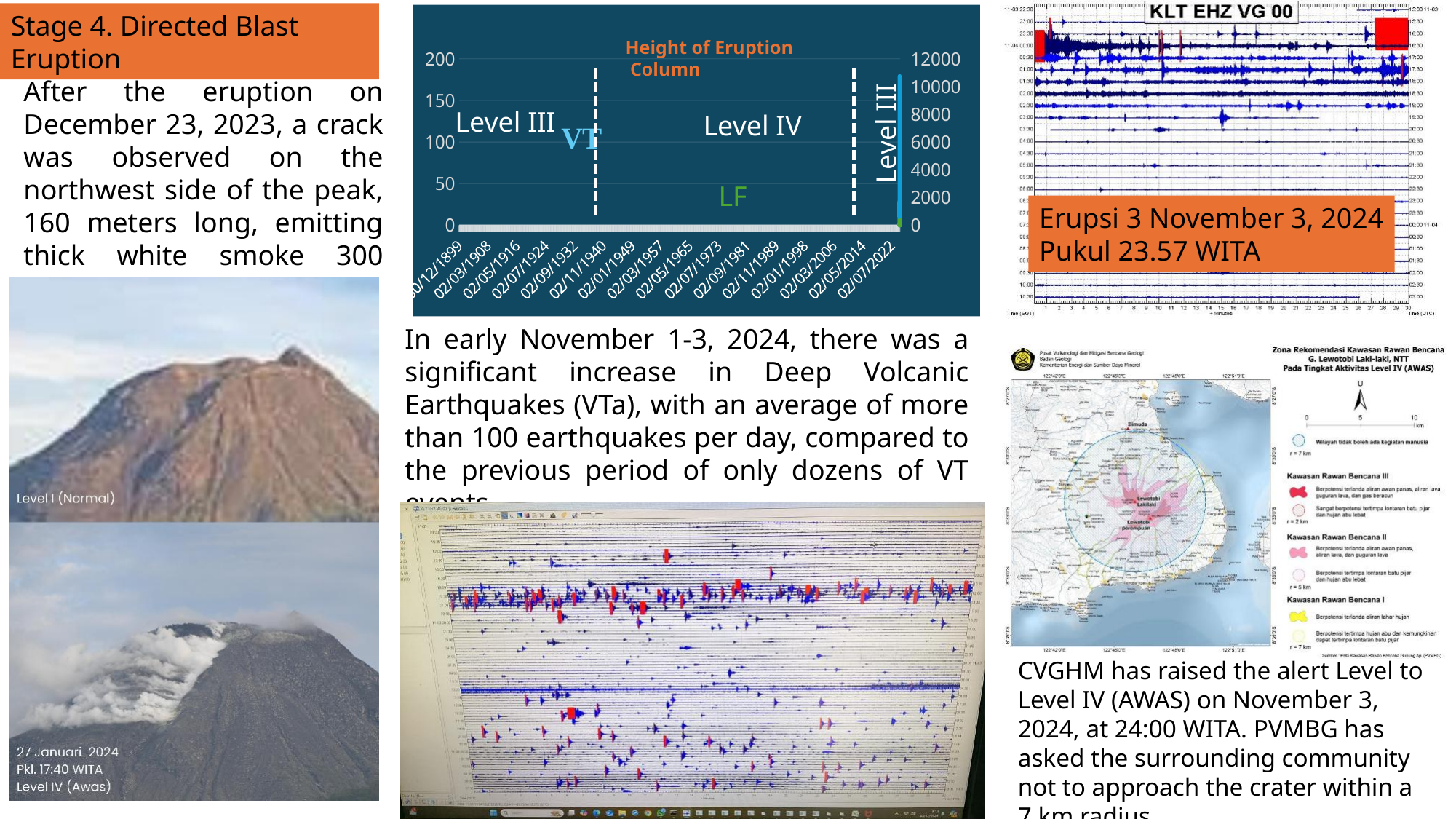
Do the values on the top-centre chart stay flat or rise sharply at the right end of the x axis? rise sharply at the right end What is the first date label on the x axis of the top-centre chart? 30/12/1899 On the top-centre chart, is the blue spike at 02/07/2022, read against the right-hand axis, greater or less than 6000? greater On the top-centre chart, is the value at 02/05/2014 greater or less than 2000 on the right-hand axis? less What is the last date label on the x axis of the top-centre chart? 02/07/2022 How many date labels are shown along the x axis of the chart at the top centre of the slide? 16